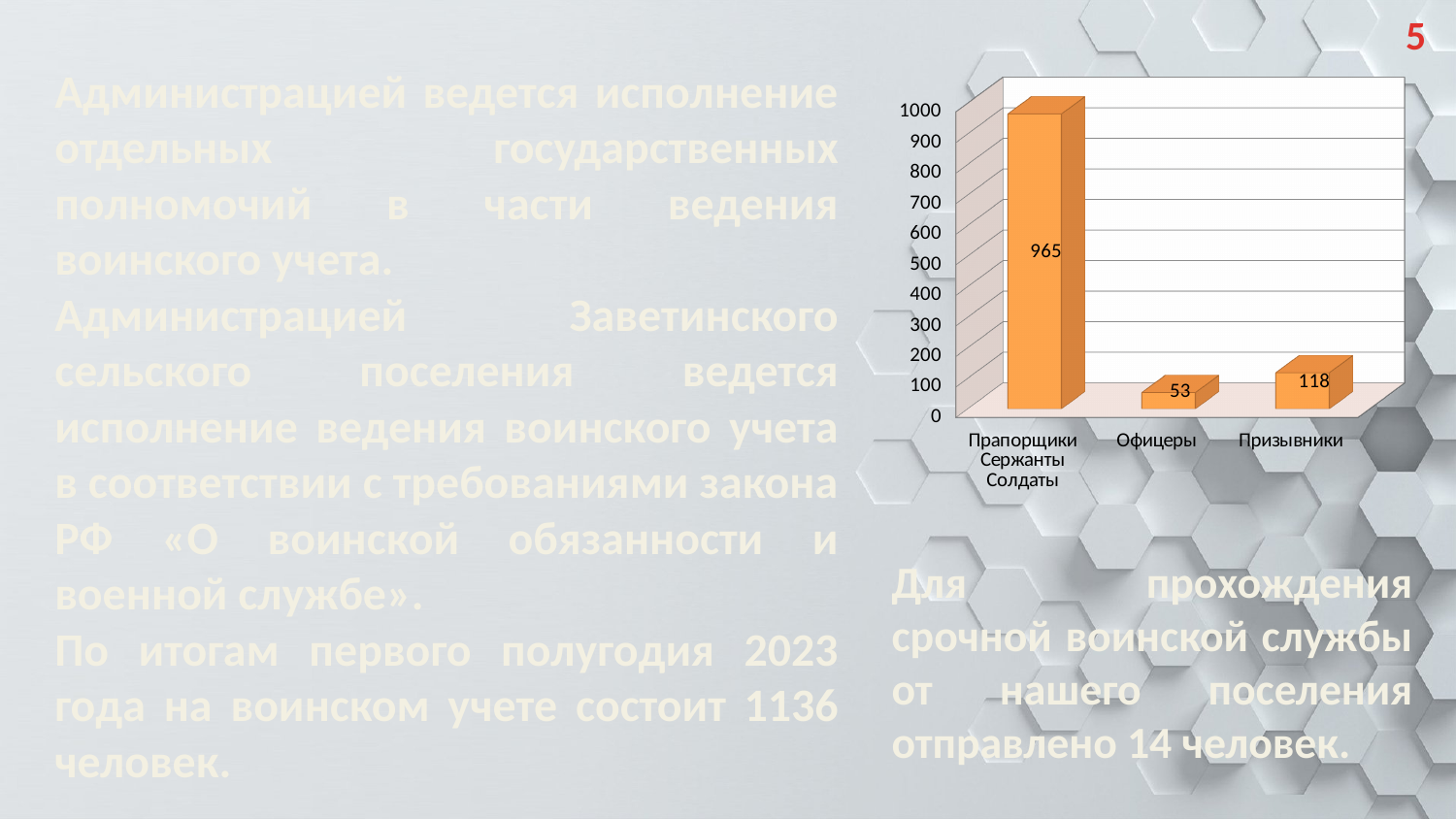
How many categories are shown on the x axis? 3 What is the value for Офицеры? 53 What kind of chart is shown on the slide? bar chart What is the difference between the values for Призывники and Офицеры? 65 What is the highest value shown on the vertical axis? 1000 Which category has the lowest value? Офицеры What is the value for Призывники? 118 Which is larger, the value for Призывники or the value for Офицеры? Призывники What is the value for Прапорщики Сержанты Солдаты? 965 Is the value for Прапорщики Сержанты Солдаты greater or less than 900? greater Which category has the highest value? Прапорщики Сержанты Солдаты What is the difference between the values for Прапорщики Сержанты Солдаты and Призывники? 847